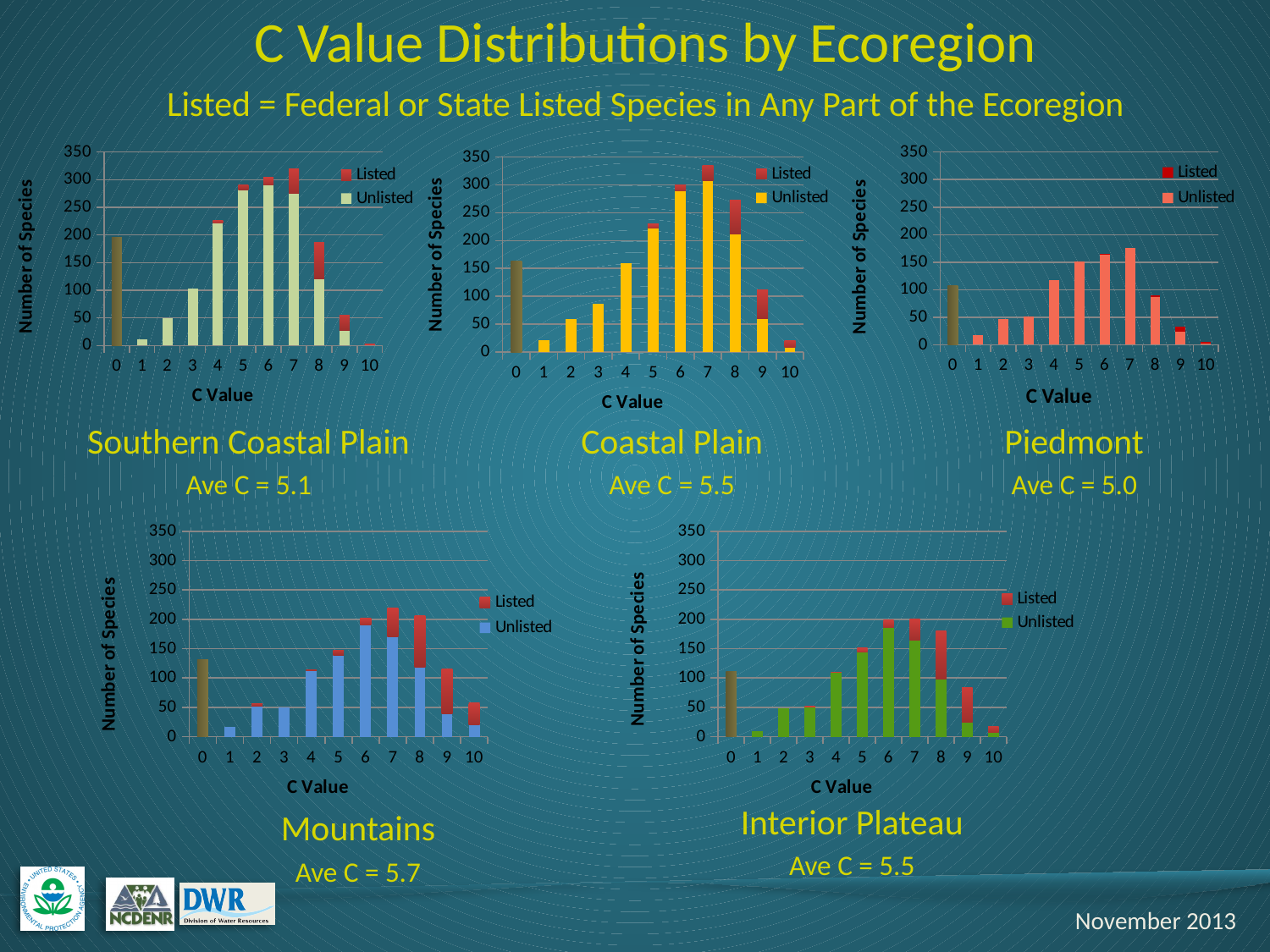
What are the two legend entries in the Mountains chart? Listed and Unlisted In the Coastal Plain chart, is the number of species for C Value 0 greater or less than 200? less In the Piedmont chart, which C Value has the tallest bar? 7 In the Southern Coastal Plain chart, which C Value has the tallest bar? 7 In the Mountains chart, is the number of species for C Value 0 greater or less than 100? greater What kind of chart is the Southern Coastal Plain chart? bar chart How many series does the legend of the Coastal Plain chart list? 2 In the Southern Coastal Plain chart, which C Value has the lowest number of species? 10 In the Piedmont chart, is the number of species for C Value 0 greater or less than 150? less How many C Value categories are shown on the x axis of the Piedmont chart? 11 In the Coastal Plain chart, which C Value has the highest number of species? 7 In the Interior Plateau chart, which has more species: C Value 5 or C Value 9? C Value 5